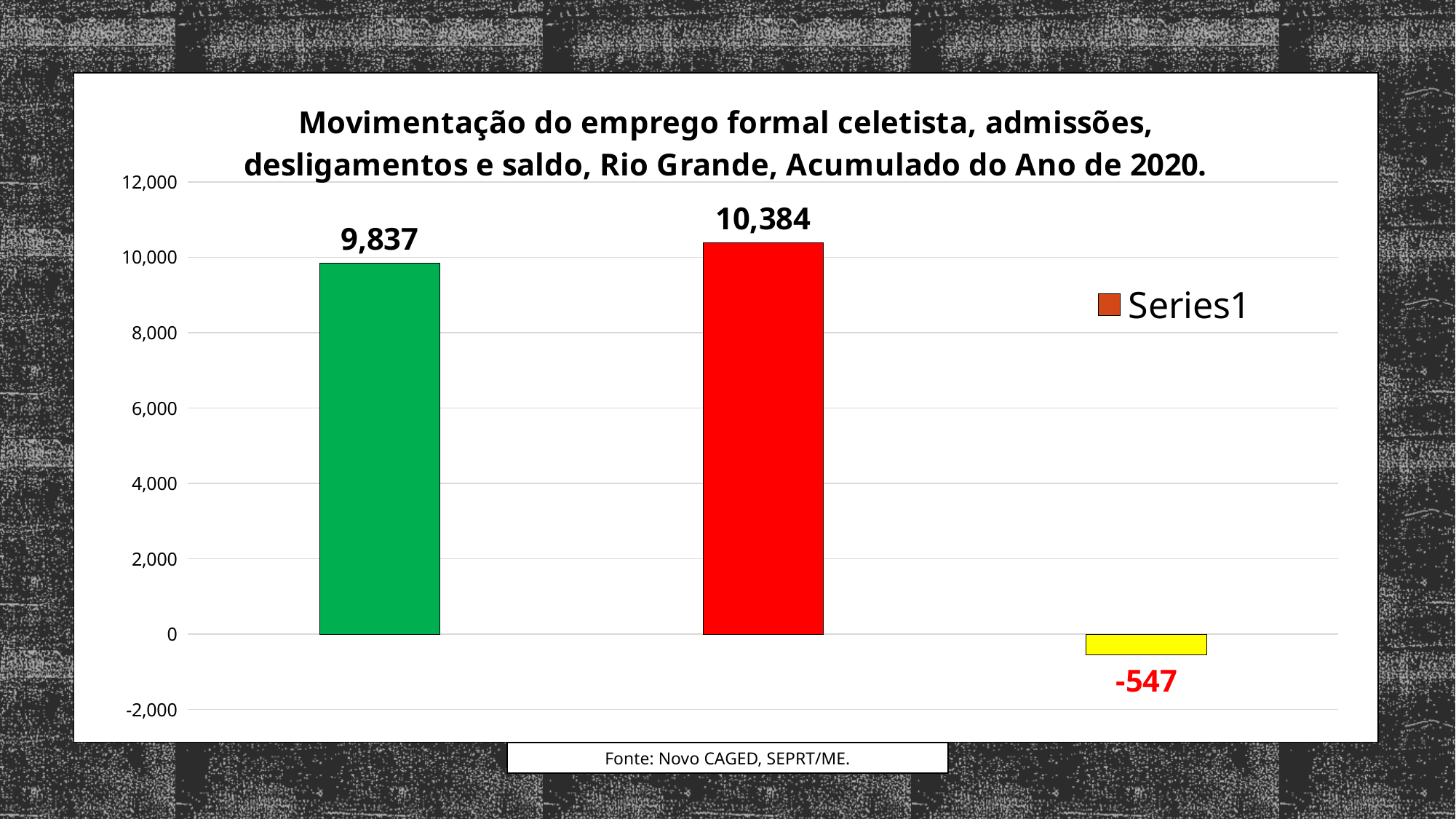
How many bars are plotted in the chart? 3 Which bar has the lowest value: the green, red or yellow bar? yellow What value is shown on the red bar? 10,384 Which bar has the highest value: the green, red or yellow bar? red What value is shown on the yellow bar? -547 What is the difference between the red bar's value and the green bar's value? 547 Which is larger, the value of the green bar or the value of the red bar? red bar How many series does the legend list? 1 What value is shown on the green bar? 9,837 Is the value of the green bar greater or less than 10,000? less What is the name of the series shown in the legend? Series1 What kind of chart is shown on the slide? bar chart